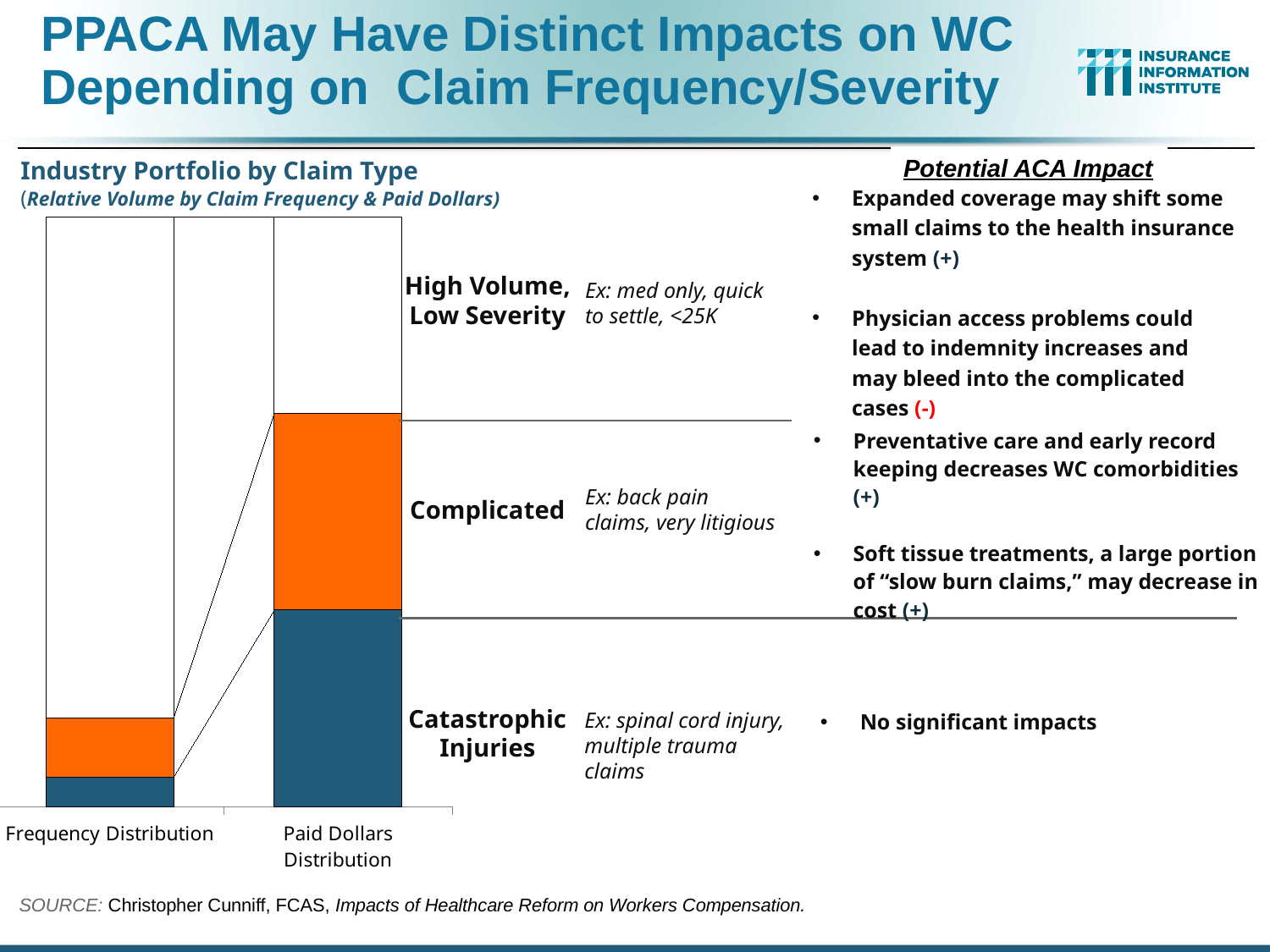
What kind of chart is shown on the slide? Stacked bar chart What are the two categories shown along the x axis of the chart? Frequency Distribution and Paid Dollars Distribution Which claim type makes up the smallest portion of the Frequency Distribution bar? Catastrophic Injuries How many categories are shown along the x axis of the chart? 2 How many claim types are stacked in each bar of the chart? 3 Is the High Volume, Low Severity segment larger in the Frequency Distribution bar or the Paid Dollars Distribution bar? Frequency Distribution Is the Catastrophic Injuries segment larger in the Frequency Distribution bar or the Paid Dollars Distribution bar? Paid Dollars Distribution Which claim type is shown in orange in the chart? Complicated Is the Complicated segment larger in the Frequency Distribution bar or the Paid Dollars Distribution bar? Paid Dollars Distribution Which claim type makes up the largest portion of the Frequency Distribution bar? High Volume, Low Severity What is the title of the chart? Industry Portfolio by Claim Type